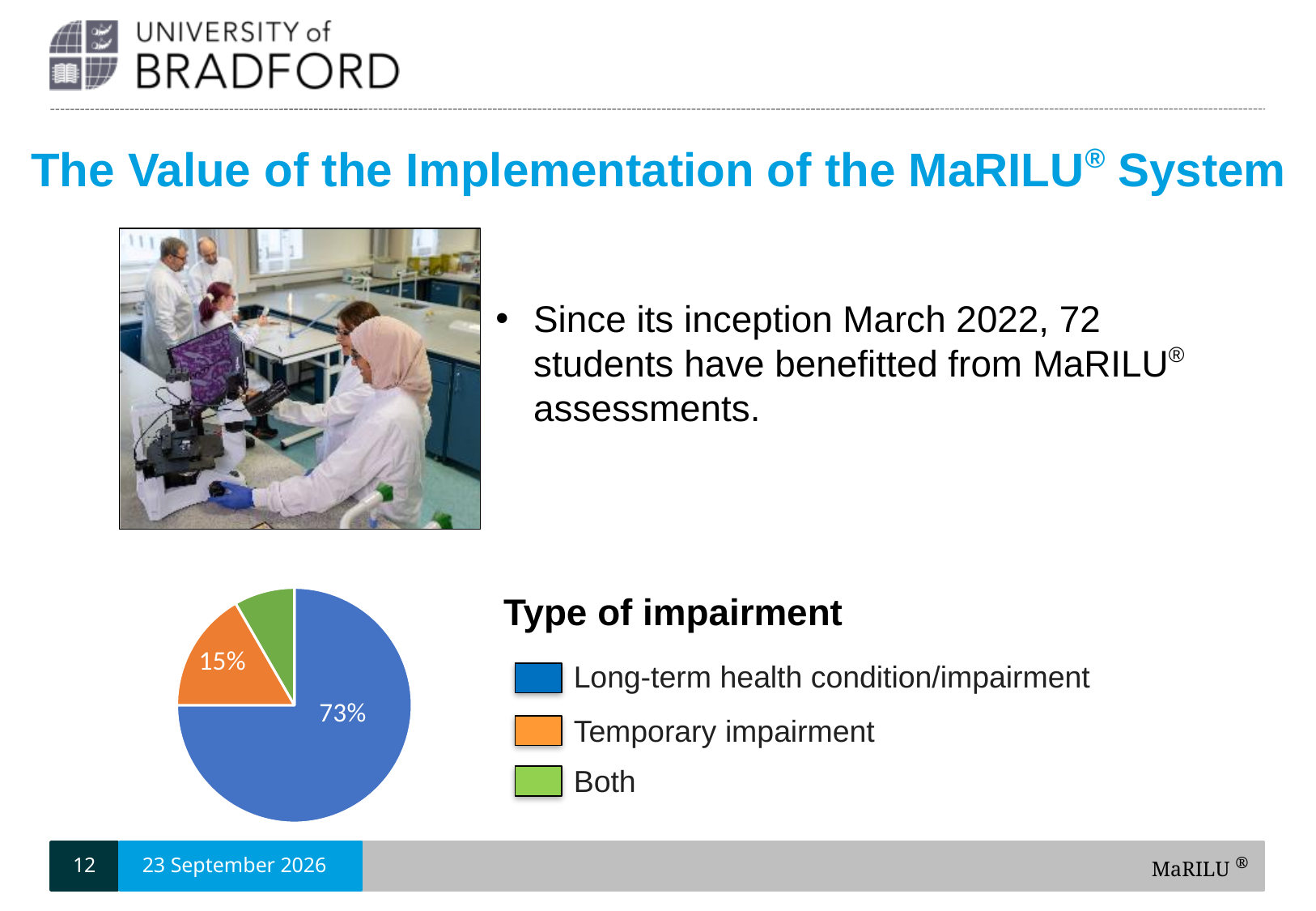
What share of the pie does Long-term health condition/impairment represent? 73% Which slice is larger: Temporary impairment or Both? Temporary impairment Which type of impairment has the smallest slice of the pie? Both Which slice is larger: Long-term health condition/impairment or Temporary impairment? Long-term health condition/impairment What is the heading shown above the pie chart's legend? Type of impairment How many slices does the pie chart have? 3 How many entries does the legend list? 3 What colour is the slice for Temporary impairment? Orange Which type of impairment has the largest slice of the pie? Long-term health condition/impairment What is the difference in percentage points between the Long-term health condition/impairment slice and the Temporary impairment slice? 58 percentage points What type of chart is shown on the slide? Pie chart What share of the pie does Temporary impairment represent? 15%